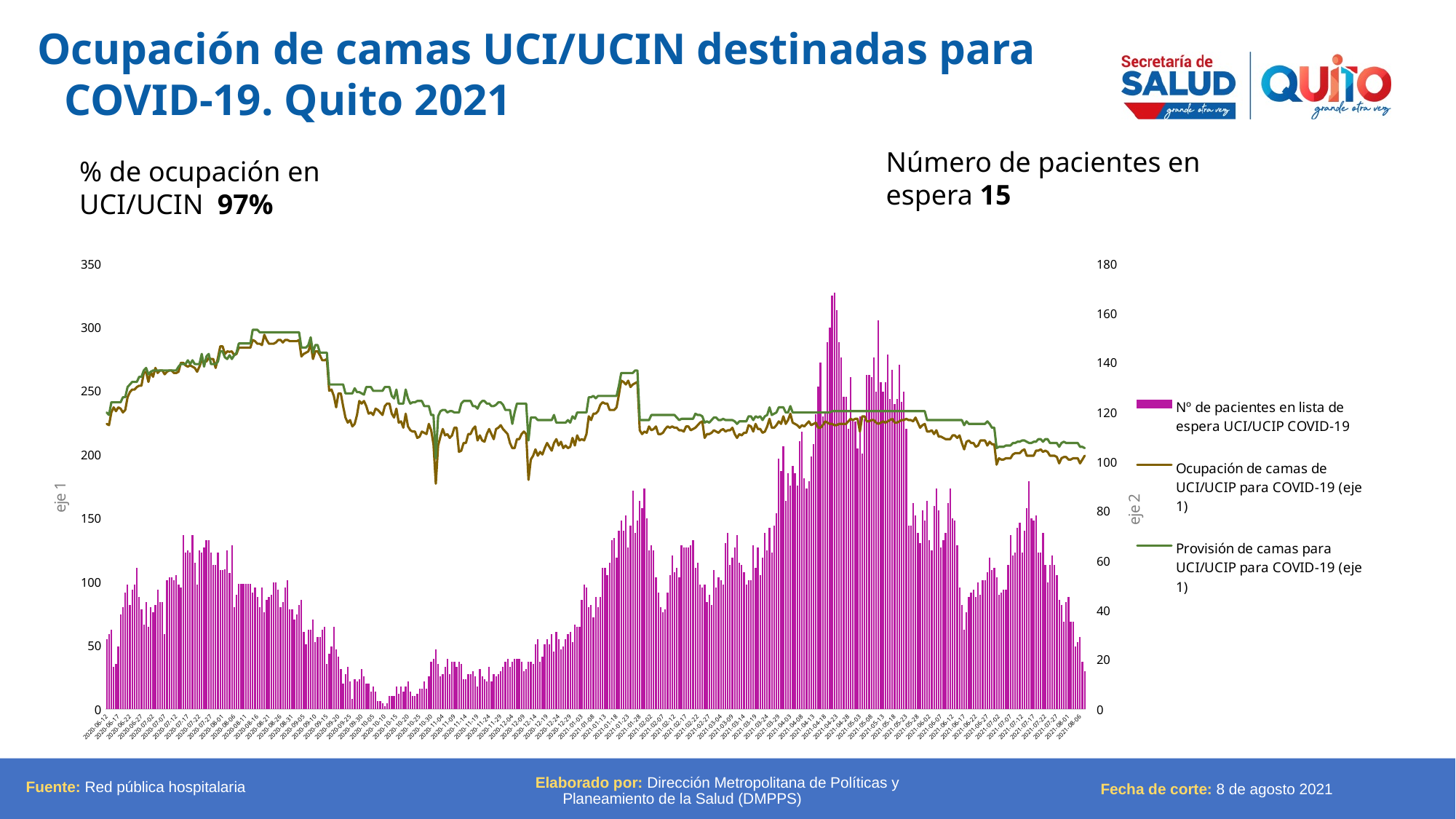
What is the highest tick value shown on the left axis (eje 1)? 350 How many patients are stated to be waiting (Número de pacientes en espera)? 15 What percentage of UCI/UCIN occupation is stated on the slide? 97% At 2020-09-25, which is higher: the Provisión de camas line or the Ocupación de camas line? Provisión de camas Which series is drawn as the green line? Provisión de camas para UCI/UCIP para COVID-19 (eje 1) Is the highest bar for Nº de pacientes en lista de espera, around April 2021, greater or less than 140 on the right axis? greater Is the value of the Provisión de camas line at 2020-08-16 greater or less than 250? greater Do the bars for Nº de pacientes en lista de espera rise or fall from 2021-07-17 to 2021-08-06? fall Which series is drawn as magenta bars? Nº de pacientes en lista de espera UCI/UCIP COVID-19 How many series does the legend list? 3 What is the highest tick value shown on the right axis (eje 2)? 180 What kind of chart is shown on the slide? A combination chart with bars and lines